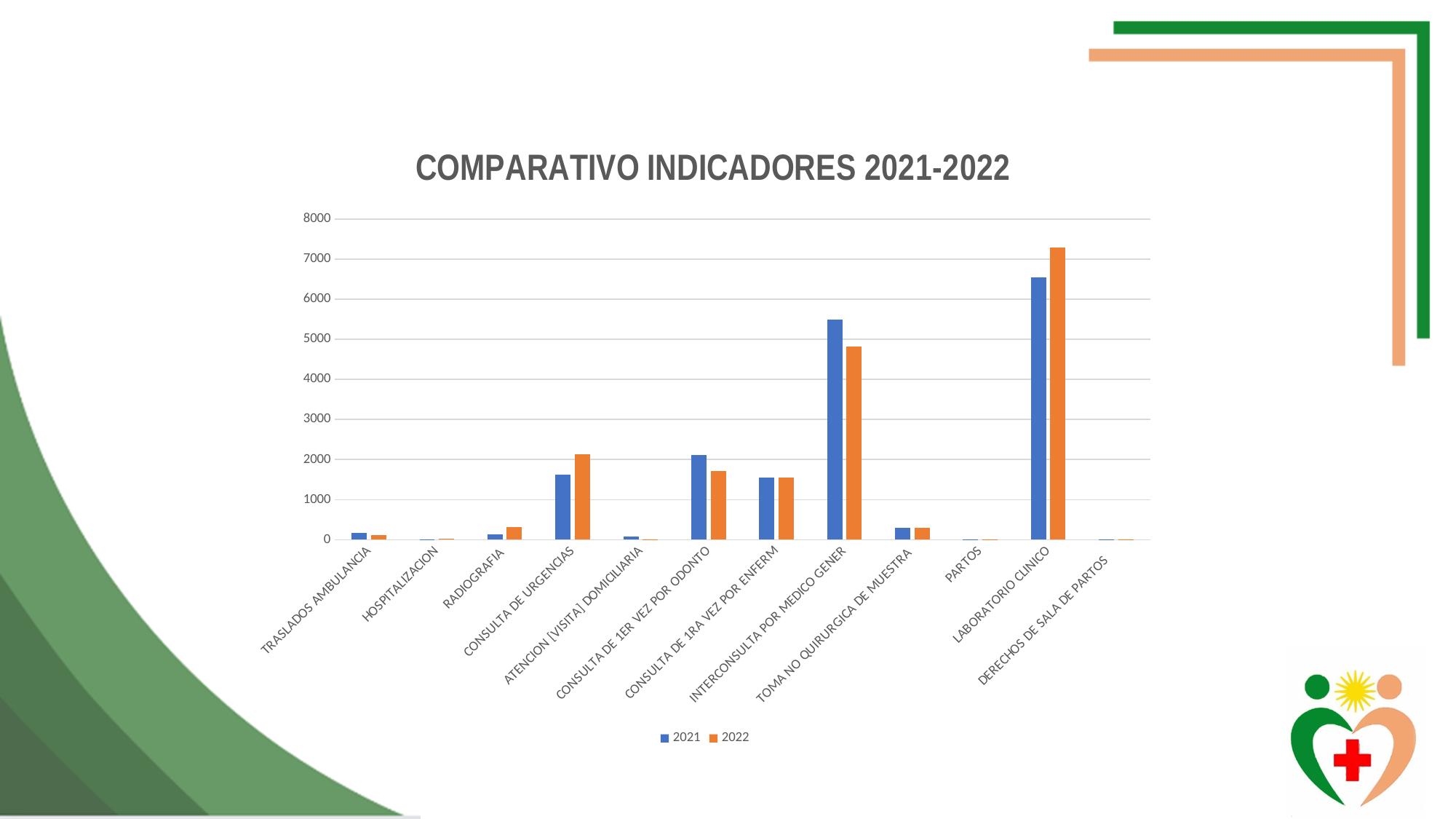
For INTERCONSULTA POR MEDICO GENER, which series has the larger value, 2021 or 2022? 2021 How many series does the legend list? 2 Which category has the highest value for the 2022 series? LABORATORIO CLINICO What type of chart is shown on the slide? bar chart Which colour represents the 2022 series in the chart? orange How many categories are shown on the x axis? 12 What is the title of the chart? COMPARATIVO INDICADORES 2021-2022 Which category has the highest value for the 2021 series? LABORATORIO CLINICO For CONSULTA DE URGENCIAS, which series has the larger value, 2021 or 2022? 2022 Is the 2021 value for INTERCONSULTA POR MEDICO GENER greater or less than 5000? greater Is the 2022 value for CONSULTA DE 1ER VEZ POR ODONTO greater or less than 2000? less Is the 2022 value for LABORATORIO CLINICO greater or less than 7000? greater